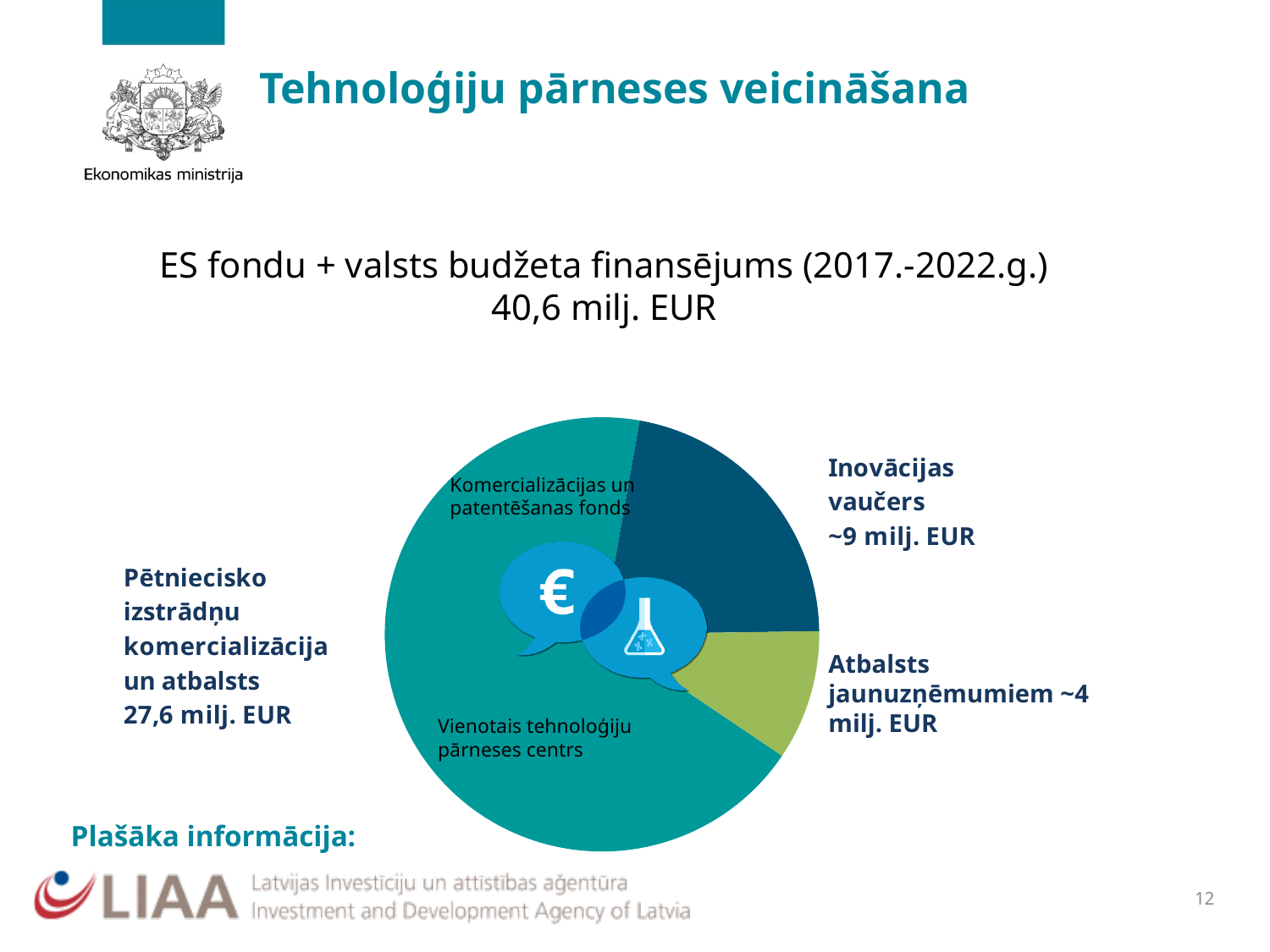
Which slice of the pie chart is the smallest? Atbalsts jaunuzņēmumiem What kind of chart is shown on the slide? pie chart What amount is shown for Inovācijas vaučers? ~9 milj. EUR Which slice is larger: Vienotais tehnoloģiju pārneses centrs or Inovācijas vaučers? Vienotais tehnoloģiju pārneses centrs What colour is the Inovācijas vaučers slice? dark blue What total funding amount for 2017-2022 is stated above the pie chart? 40,6 milj. EUR What amount is shown for Atbalsts jaunuzņēmumiem? ~4 milj. EUR Which slice is larger: Inovācijas vaučers or Atbalsts jaunuzņēmumiem? Inovācijas vaučers Which slice of the pie chart is the largest? Pētniecisko izstrādņu komercializācija un atbalsts How many slices does the pie chart have? 3